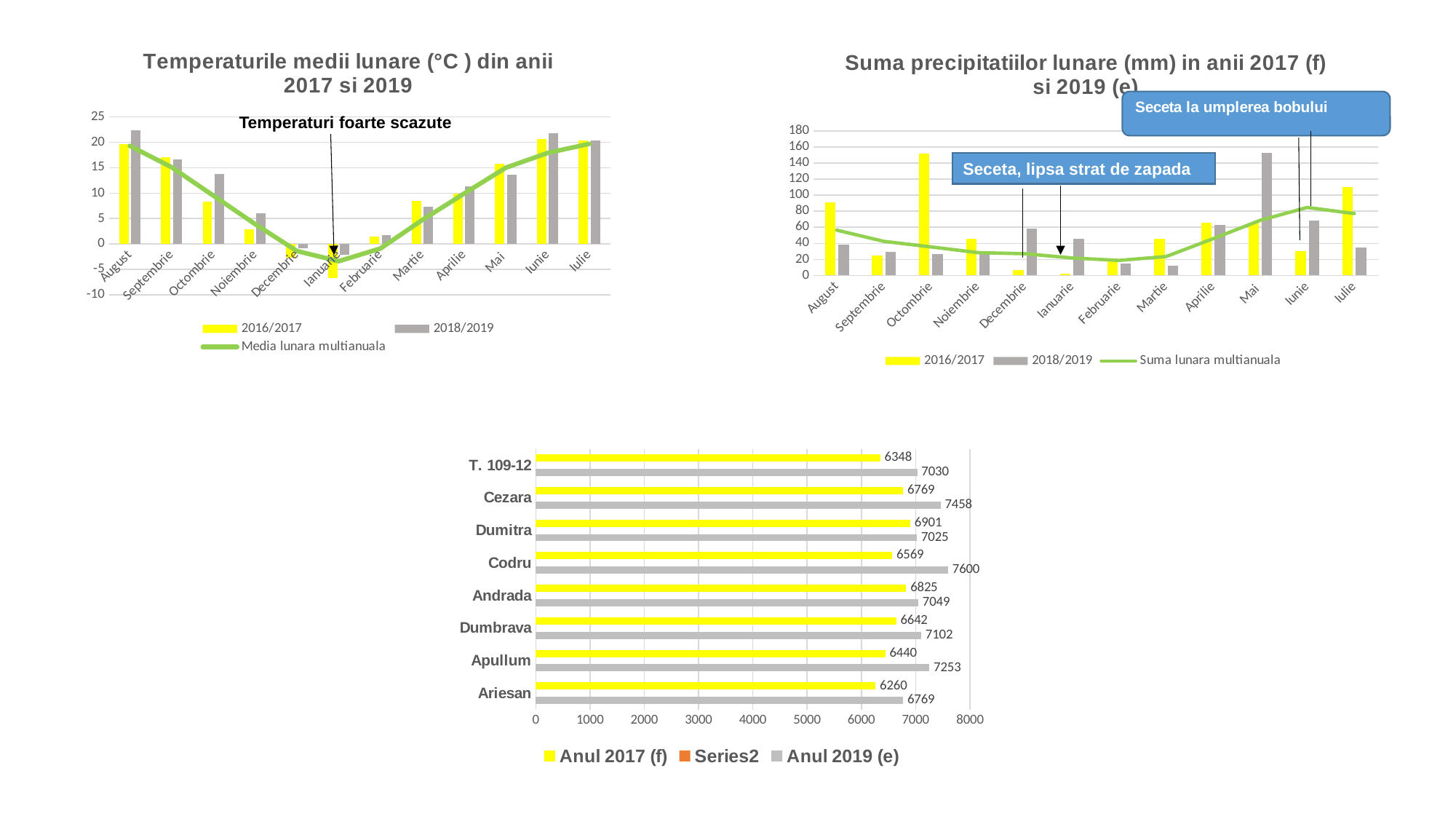
In the bottom chart, which is larger: the Anul 2017 (f) value for Dumitra or for Apullum? Dumitra In the chart titled 'Suma precipitatiilor lunare (mm) in anii 2017 (f) si 2019 (e)', which month has the highest 2016/2017 value? Octombrie How many series does the legend of the bottom chart list? 3 In the bottom chart, what is the value for Codru in the Anul 2019 (e) series? 7600 In the bottom chart, which category has the lowest Anul 2017 (f) value? Ariesan How many categories are shown in the bottom chart? 8 In the bottom chart, what is the value for Ariesan in the Anul 2017 (f) series? 6260 What kind of chart is the bottom chart? bar chart In the bottom chart, which category has the highest Anul 2019 (e) value? Codru In the chart titled 'Temperaturile medii lunare (°C) din anii 2017 si 2019', is the 2018/2019 value for August greater or less than 20? greater In the bottom chart, what is the difference between the Anul 2019 (e) and Anul 2017 (f) values for Codru? 1031 In the chart titled 'Temperaturile medii lunare (°C) din anii 2017 si 2019', which month has the lowest 2016/2017 value? Ianuarie